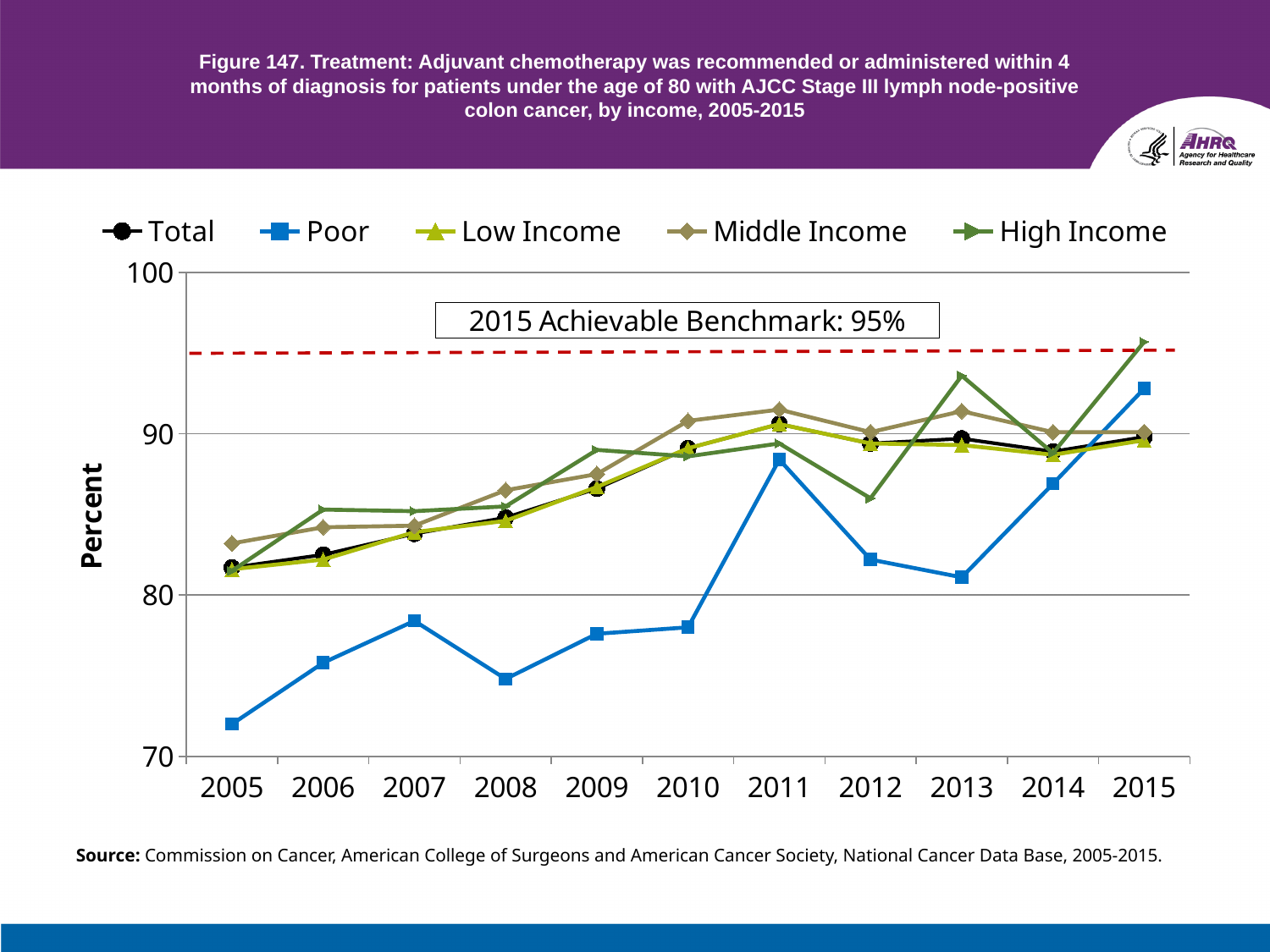
Is the value for Poor in 2011 greater or less than 80? greater What is the label of the y axis? Percent Which series has the lowest value in 2005? Poor Is the value for High Income in 2015 greater or less than 90? greater What kind of chart is shown on the slide? line chart How many series does the legend list? 5 Which series has the highest value in 2015? High Income Is the value for Poor in 2015 greater or less than 90? greater For the Poor series, which year has the larger value, 2011 or 2012? 2011 What is the 2015 Achievable Benchmark shown on the chart? 95% How many years are plotted along the x axis? 11